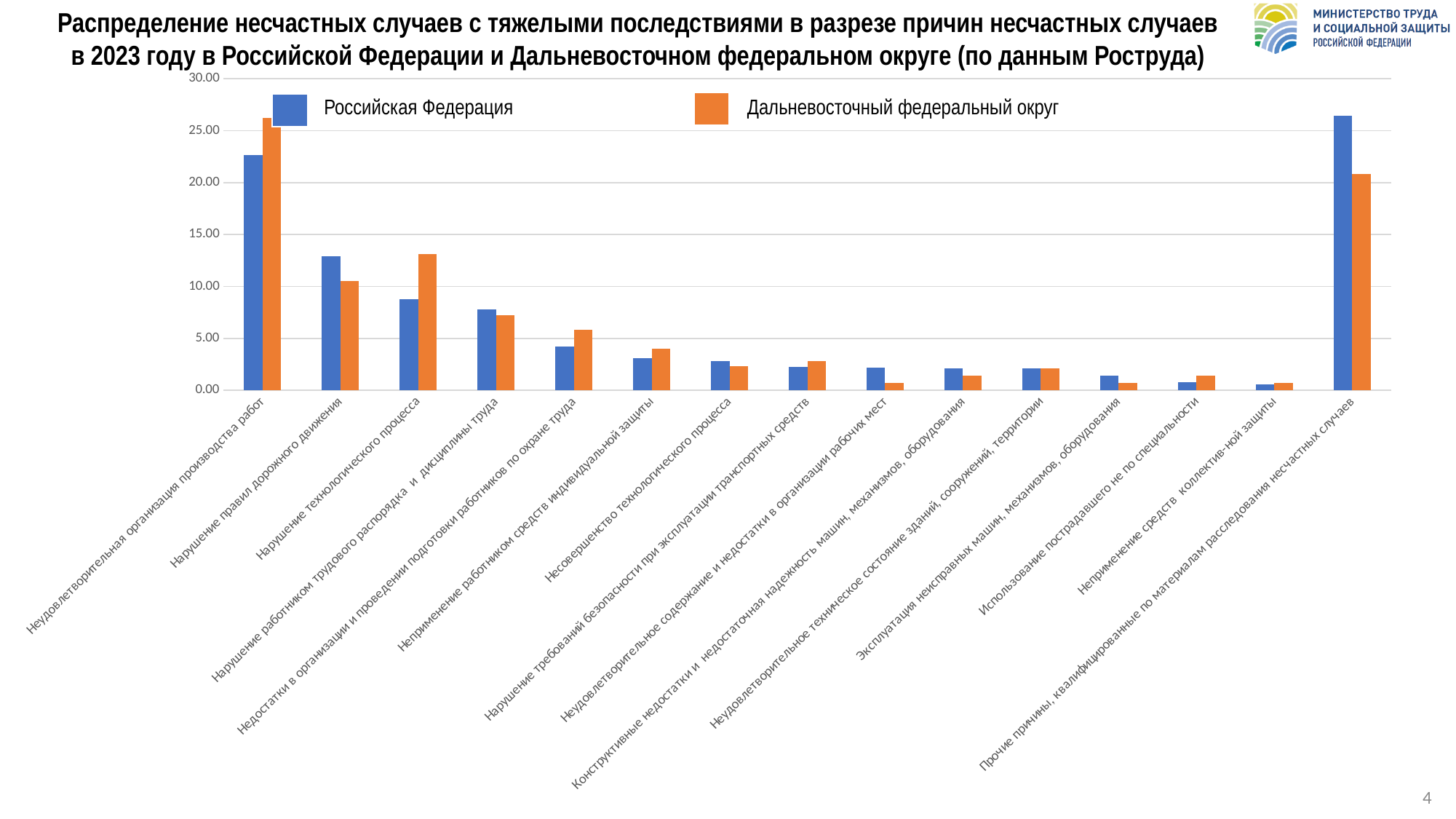
Is the Российская Федерация value for Неудовлетворительная организация производства работ greater or less than 20.00? greater What kind of chart is shown on the slide? Bar chart For Нарушение правил дорожного движения, which series has the larger value: Российская Федерация or Дальневосточный федеральный округ? Российская Федерация Which colour represents the Дальневосточный федеральный округ series in the legend? Orange How many cause categories are plotted along the x axis? 15 Which category has the highest value for the Российская Федерация series? Прочие причины, квалифицированные по материалам расследования несчастных случаев Is the Дальневосточный федеральный округ value for Нарушение технологического процесса greater or less than 10.00? greater Which category has the highest value for the Дальневосточный федеральный округ series? Неудовлетворительная организация производства работ For Нарушение технологического процесса, which series has the larger value: Российская Федерация or Дальневосточный федеральный округ? Дальневосточный федеральный округ How many series does the legend list? 2 Is the Дальневосточный федеральный округ value for Прочие причины, квалифицированные по материалам расследования несчастных случаев greater or less than 20.00? greater